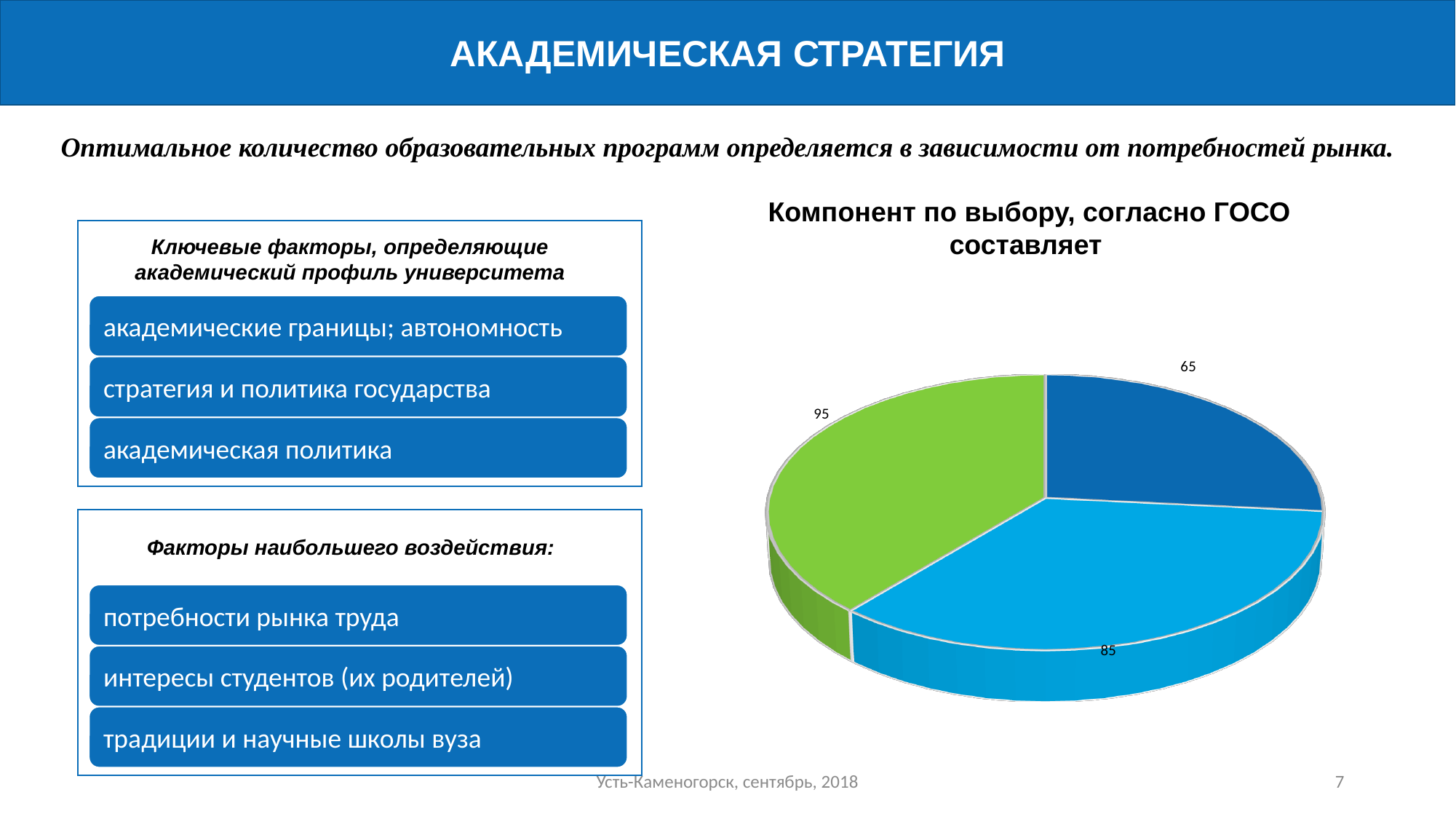
Which is larger in the pie chart: the light blue slice or the dark blue slice? the light blue slice (85) What value is shown for the light blue slice of the pie chart? 85 How many slices does the pie chart have? 3 What is the title of the pie chart? Компонент по выбору, согласно ГОСО составляет What is the difference between the green slice and the light blue slice in the pie chart? 10 What value is shown for the green slice of the pie chart? 95 Which slice of the pie chart has the largest value? the green slice (95) Which slice of the pie chart has the smallest value? the dark blue slice (65) What is the total of all three values in the pie chart? 245 What value is shown for the dark blue slice of the pie chart? 65 What kind of chart is shown on the slide? pie chart What is the difference between the largest and smallest values in the pie chart? 30